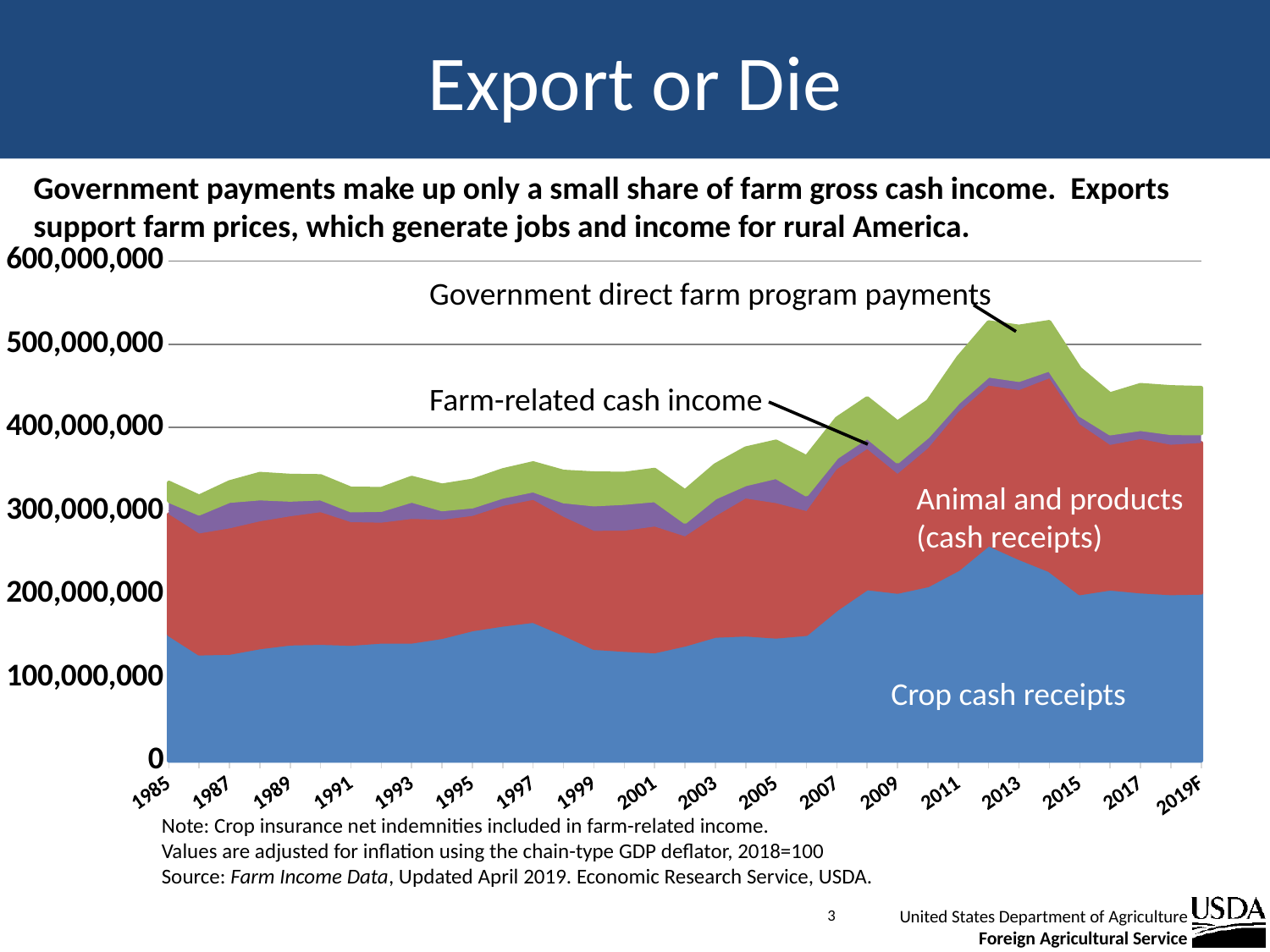
How many year labels appear on the x axis? 18 Which series forms the bottom layer of the stacked area chart? Crop cash receipts Do Crop cash receipts rise or fall between 2007 and 2013? rise Is the total stacked value in 2013 greater or less than 500,000,000? greater Is the total stacked value in 1985 greater or less than 300,000,000? greater Is the value for Crop cash receipts in 2013 greater or less than 200,000,000? greater Does the total stacked value rise or fall between 2013 and 2017? fall What kind of chart is shown on the slide? Stacked area chart What is the title of the slide containing the chart? Export or Die How many series are labeled on the chart? 4